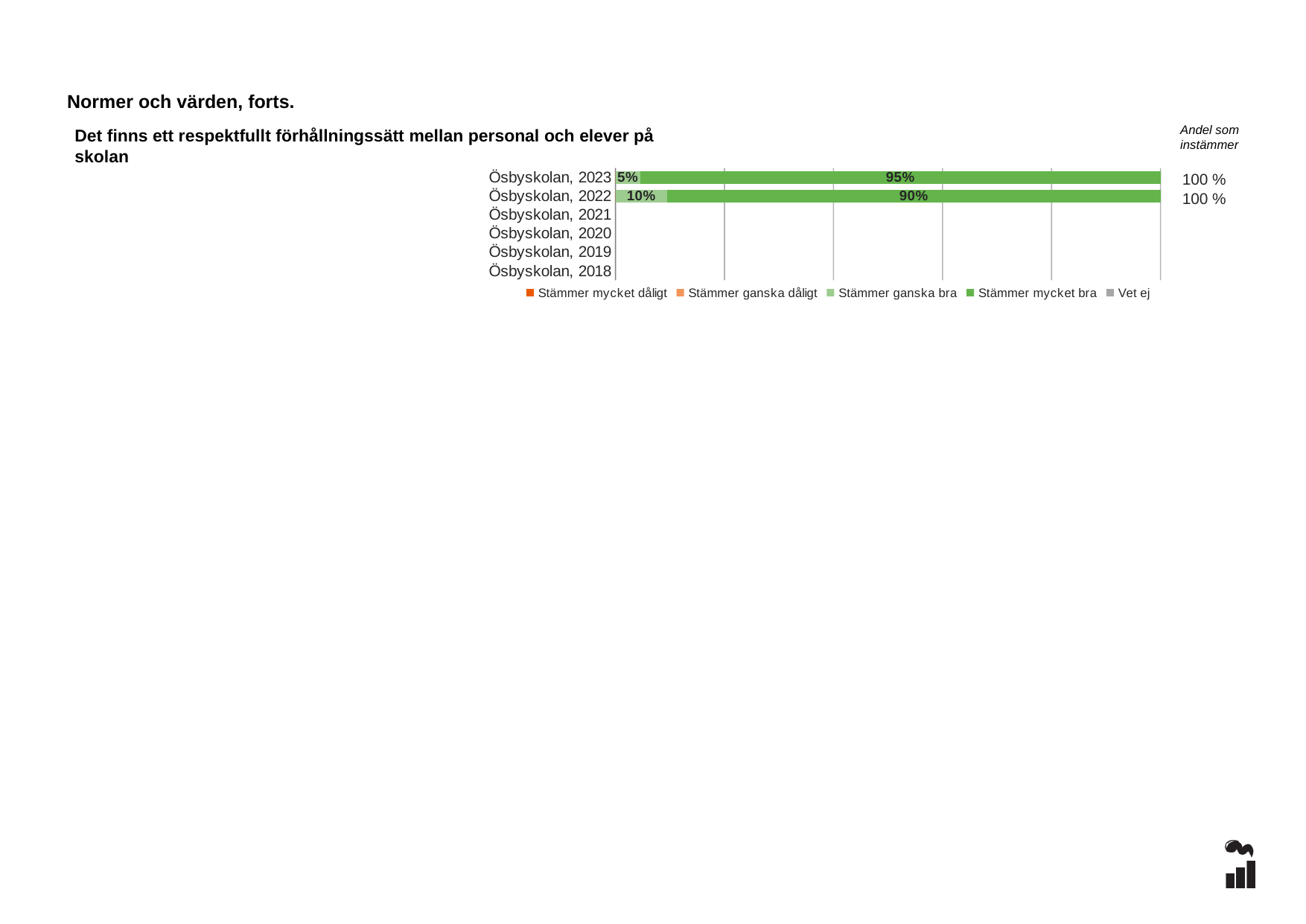
What is the value for "Stämmer ganska bra" for Ösbyskolan, 2022? 10% How many categories are listed on the vertical axis of the chart? 6 What is the value for "Stämmer mycket bra" for Ösbyskolan, 2023? 95% Which is larger: the "Stämmer mycket bra" value for Ösbyskolan, 2023 or for Ösbyskolan, 2022? Ösbyskolan, 2023 What is the total of the stacked bar for Ösbyskolan, 2022? 100% What kind of chart is shown on the slide? bar chart What is the difference between the "Stämmer ganska bra" values for Ösbyskolan, 2022 and Ösbyskolan, 2023? 5% How many series does the legend list? 5 What is the value for "Stämmer mycket bra" for Ösbyskolan, 2022? 90% What is the "Andel som instämmer" value shown for Ösbyskolan, 2023? 100 % Which legend entry is shown in dark green? Stämmer mycket bra What is the value for "Stämmer ganska bra" for Ösbyskolan, 2023? 5%